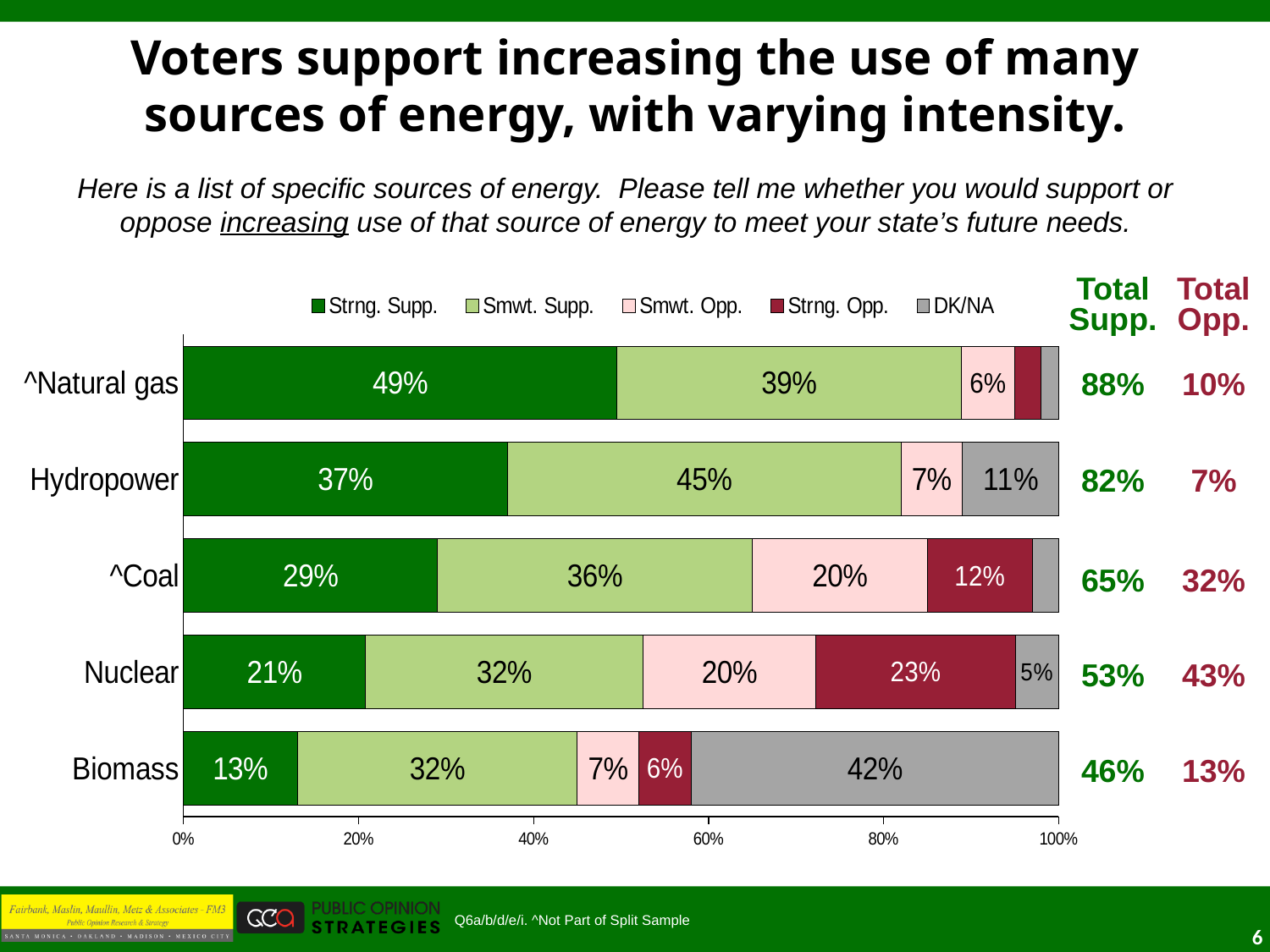
What percentage of voters somewhat support increasing the use of hydropower? 45% What is the Total Opp. figure shown for nuclear? 43% What type of chart is shown on the slide? Stacked bar chart What is the DK/NA percentage for biomass? 42% What is the difference between the strong opposition percentages for nuclear and coal? 11% Which has a larger somewhat support percentage, natural gas or coal? Natural gas How many energy sources are shown in the chart? 5 What percentage of voters strongly support increasing the use of natural gas? 49% What is the Total Supp. figure shown for coal? 65% Which energy source has the highest strong support percentage? ^Natural gas Which energy source has the lowest Total Supp. figure? Biomass How many series does the legend list? 5